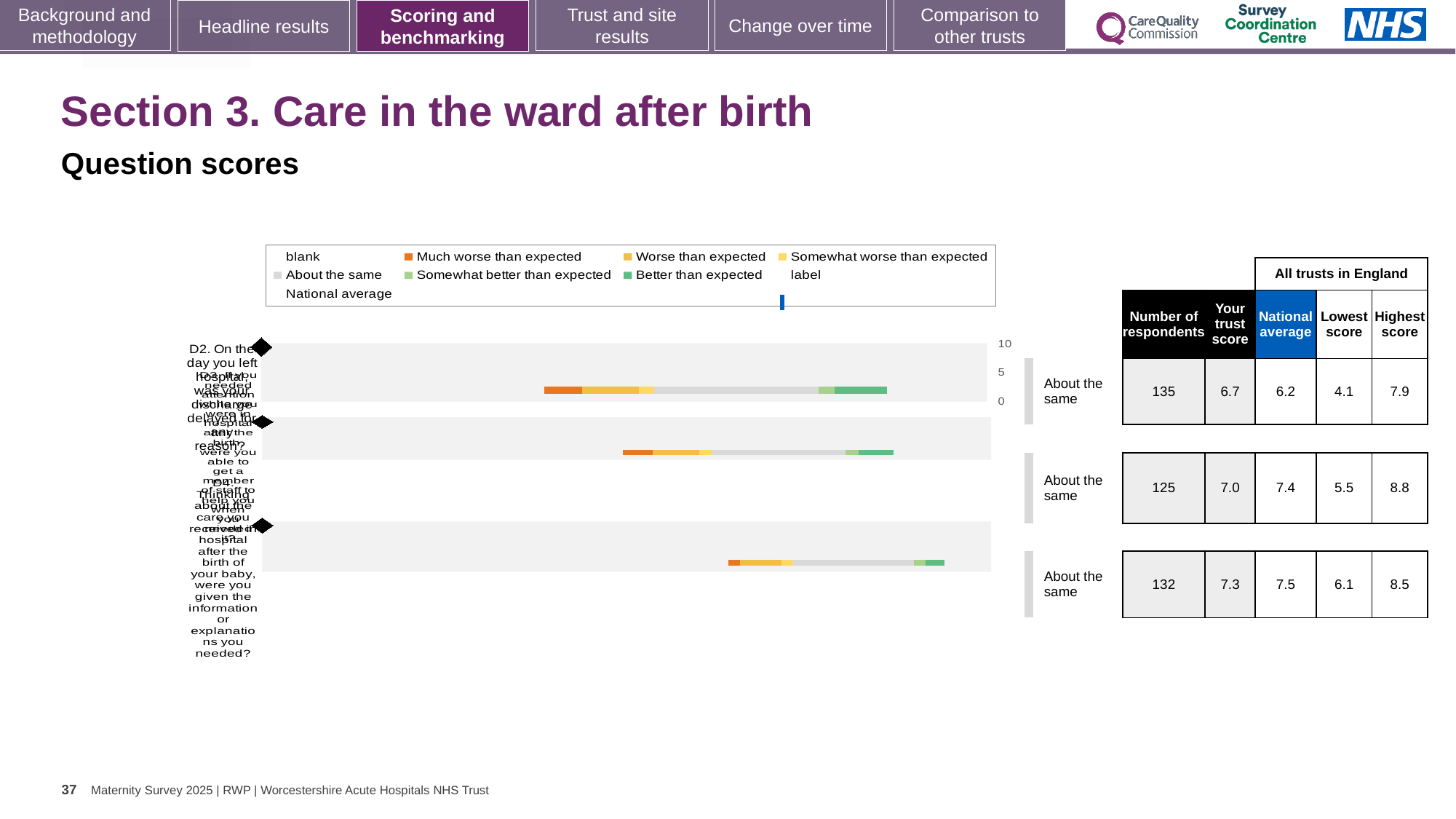
In the table beside the chart, for the first row, which is larger: the trust score or the national average? the trust score (6.7) In the table beside the chart, what is the highest score for the third row? 8.5 What kind of chart is shown on the slide? bar chart In the table beside the chart, what is the number of respondents for the first row? 135 How many stacked bars are plotted in the chart? 3 In the table beside the chart, what is the 'Your trust score' for the first row? 6.7 In the chart legend, what colour represents 'Much worse than expected'? orange In the table beside the chart, what is the difference between the national average and the trust score in the second row? 0.4 In the table beside the chart, which row has the highest 'Your trust score'? the third row (7.3) In the table beside the chart, which row has the lowest 'Lowest score'? the first row (4.1) In the chart legend, what colour represents 'Better than expected'? green In the table beside the chart, what is the national average for the second row? 7.4